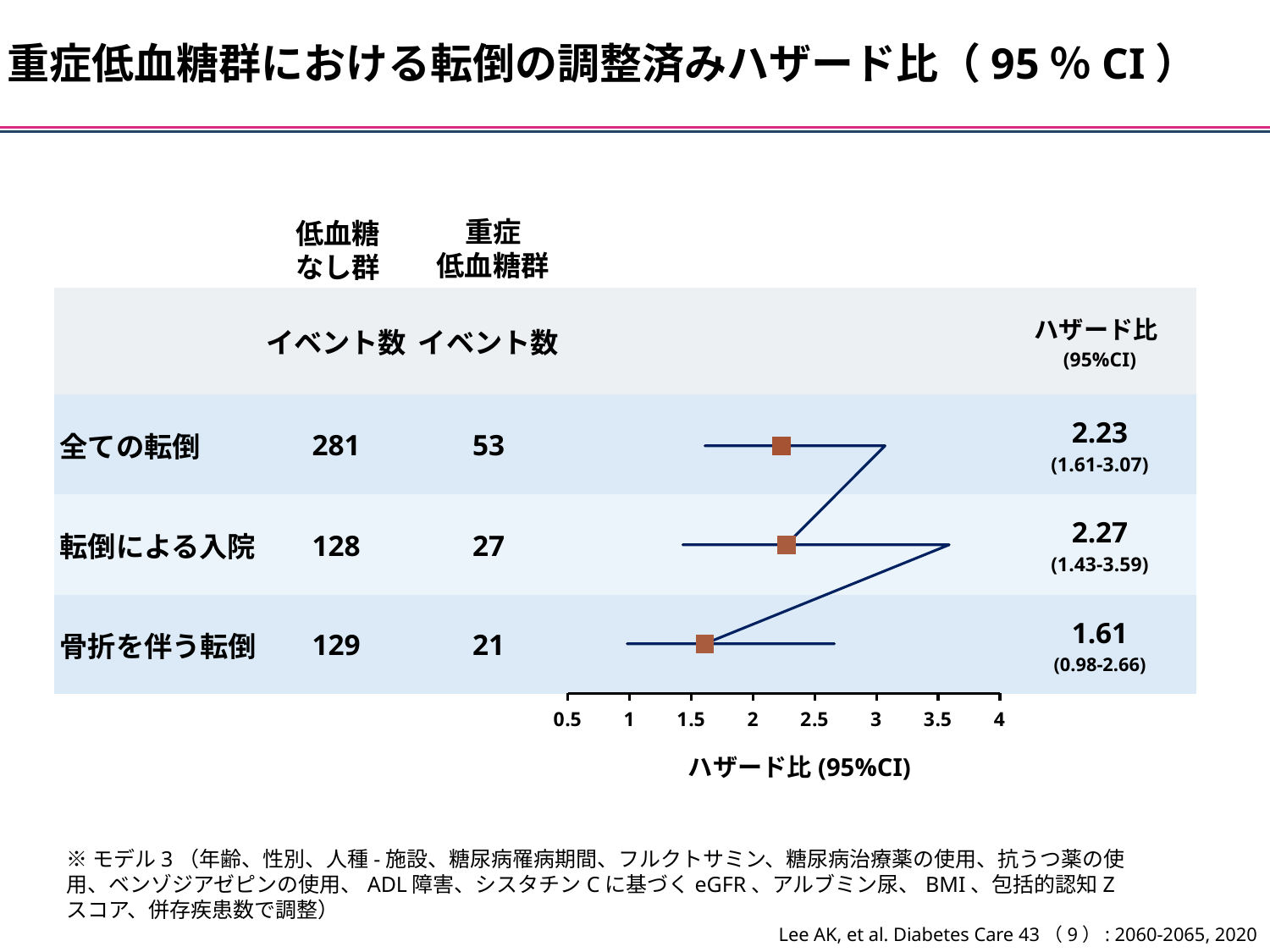
How many outcomes are plotted in the chart? 3 What is the difference between the hazard ratios for 転倒による入院 and 骨折を伴う転倒? 0.66 What is the hazard ratio for 全ての転倒? 2.23 Which outcome has the lowest hazard ratio? 骨折を伴う転倒 What is the 95% CI for the hazard ratio of 骨折を伴う転倒? 0.98-2.66 Which outcome has the highest hazard ratio? 転倒による入院 What is the hazard ratio for 骨折を伴う転倒? 1.61 What is the label of the x axis of the chart? ハザード比 (95%CI) Which has a larger hazard ratio, 全ての転倒 or 骨折を伴う転倒? 全ての転倒 How many events were there in the 低血糖なし群 for 転倒による入院? 128 How many events were there in the 重症低血糖群 for 全ての転倒? 53 What is the hazard ratio for 転倒による入院? 2.27